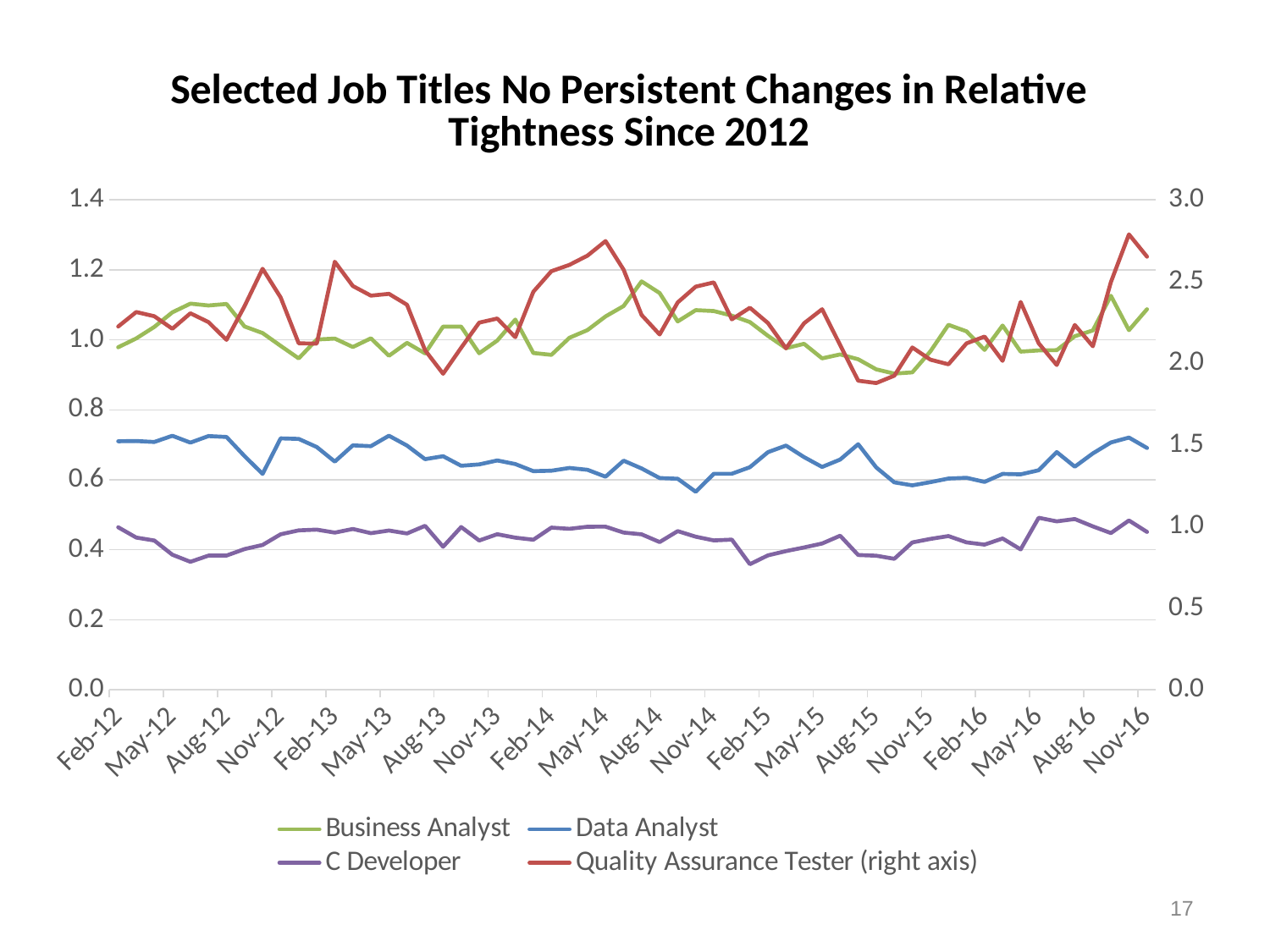
Is the value for C Developer in Feb-12 greater or less than 0.6? less In Feb-12, which is higher: Data Analyst or C Developer? Data Analyst What kind of chart is shown on the slide? Line chart Which series is plotted against the right axis? Quality Assurance Tester Is the value for Data Analyst in Feb-12 greater or less than 0.6? greater Is the value for Business Analyst in Feb-12 greater or less than 0.8? greater Which series has the lowest values throughout the chart? C Developer How many series does the legend list? 4 What is the title of the chart? Selected Job Titles No Persistent Changes in Relative Tightness Since 2012 How many date labels appear on the x axis? 20